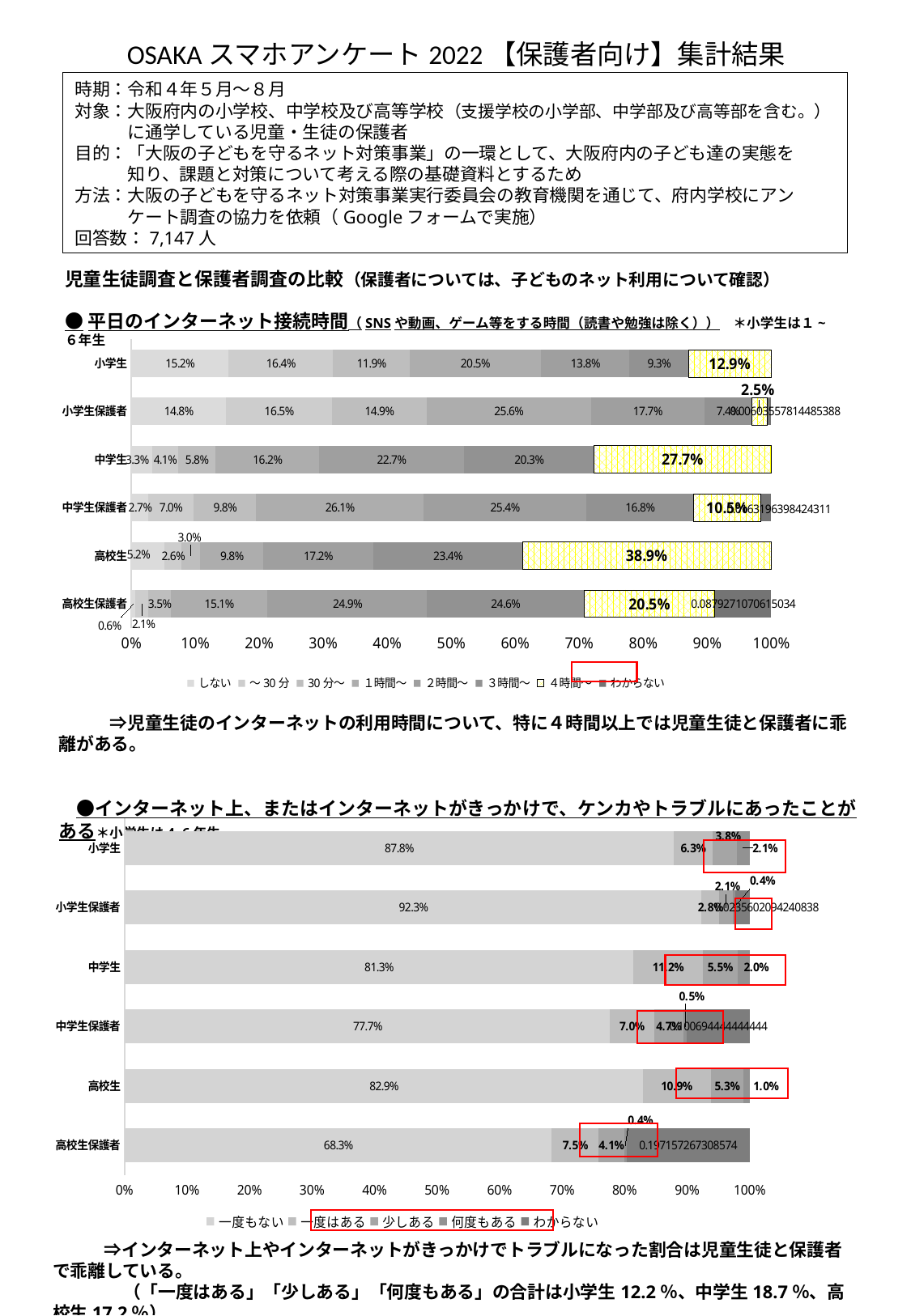
In the top chart (平日のインターネット接続時間), how many categories (bars) are shown? 6 In the bottom chart (ケンカやトラブルにあったことがある), what is the 一度はある value for 中学生? 11.2% What kind of chart is the bottom chart (ケンカやトラブルにあったことがある)? Stacked bar chart In the top chart (平日のインターネット接続時間), what is the value of the 4時間～ segment for 高校生? 38.9% In the top chart (平日のインターネット接続時間), what is the value of the 1時間～ segment for 小学生保護者? 25.6% In the bottom chart (ケンカやトラブルにあったことがある), what is the 一度もない value for 高校生保護者? 68.3% In the top chart (平日のインターネット接続時間), which category has the largest 4時間～ segment? 高校生 In the top chart (平日のインターネット接続時間), what is the difference between the 4時間～ values for 高校生 and 高校生保護者? 18.4 percentage points In the top chart (平日のインターネット接続時間), which has the larger 4時間～ value, 中学生 or 中学生保護者? 中学生 In the bottom chart (ケンカやトラブルにあったことがある), which category has the smallest 一度もない segment? 高校生保護者 In the top chart (平日のインターネット接続時間), how many series does the legend list? 8 In the bottom chart (ケンカやトラブルにあったことがある), how many series does the legend list? 5